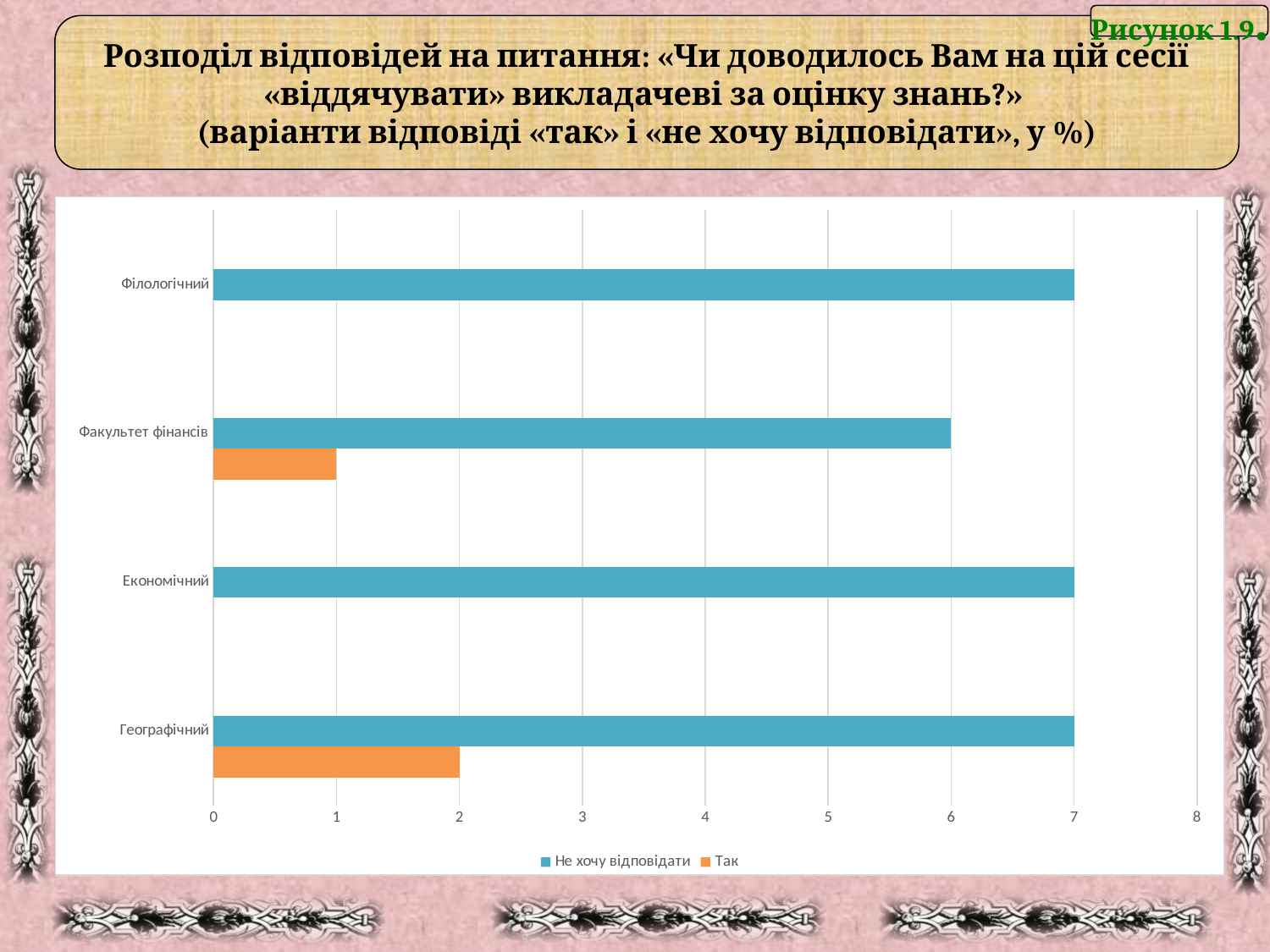
Which is larger: the «Так» value for Географічний or the «Так» value for Факультет фінансів? Географічний How many faculties (categories) are shown on the chart? 4 How many series does the legend list? 2 What is the value of «Не хочу відповідати» for Філологічний? 7 What is the value of «Так» for Факультет фінансів? 1 What kind of chart is shown on the slide? bar chart Which faculty has the lowest value for «Не хочу відповідати»? Факультет фінансів What is the difference between the «Не хочу відповідати» and «Так» values for Географічний? 5 What is the value of «Так» for Географічний? 2 Which faculty has the highest value for «Так»? Географічний Which colour represents the «Так» series in the legend? orange What is the value of «Не хочу відповідати» for Факультет фінансів? 6